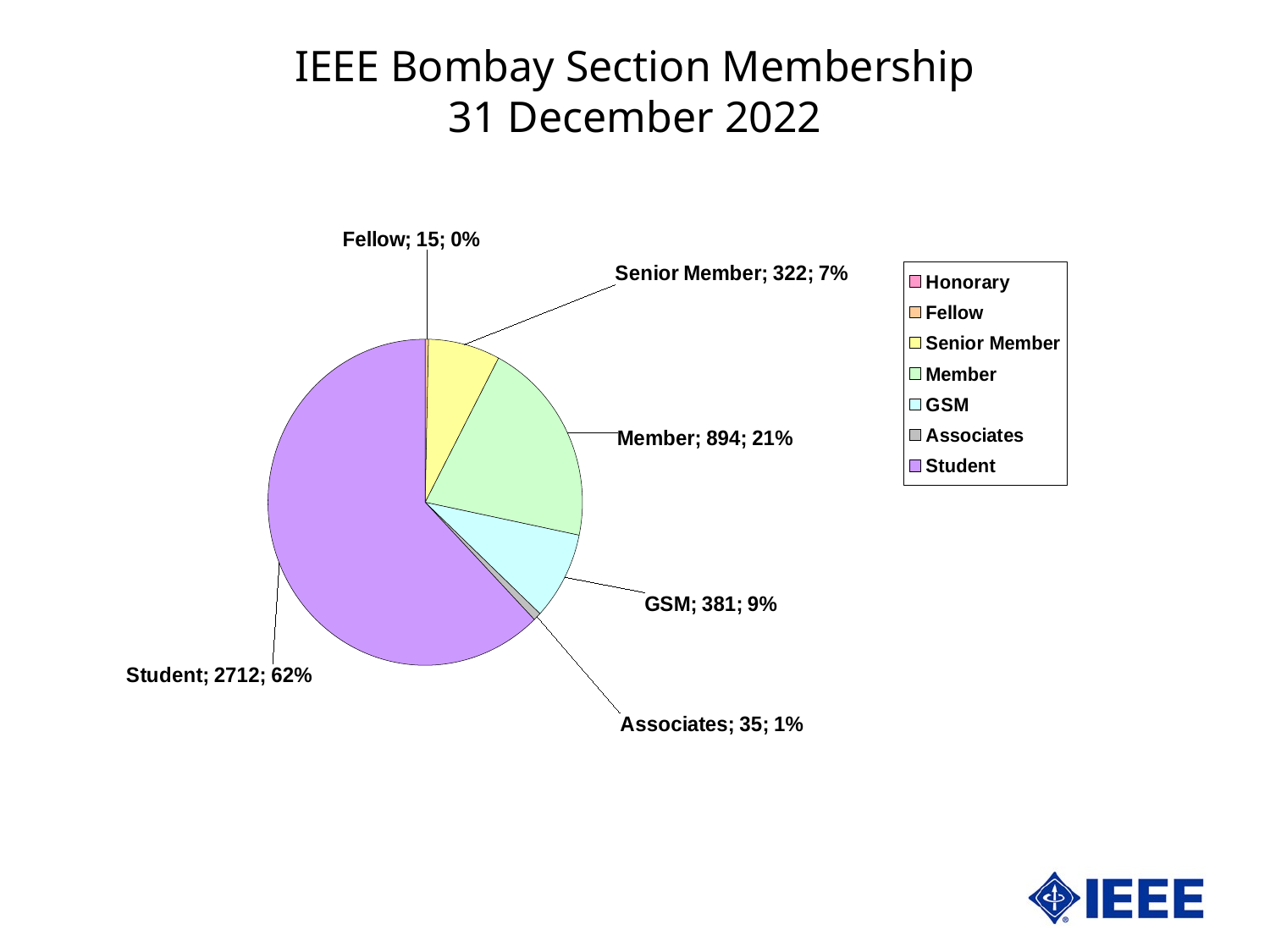
How many members are in the Student category? 2712 What is the title of the chart on the slide? IEEE Bombay Section Membership 31 December 2022 How many entries does the legend list? 7 Which category has the largest slice of the pie? Student Which of the labeled slices has the smallest value? Fellow What is the value shown for Member? 894 What type of chart is shown on the slide? pie chart What is the value shown for Senior Member? 322 What percentage share of the pie does the Member slice represent? 21% What is the value shown for GSM? 381 What percentage share of the pie does the Student slice represent? 62% What is the difference between the Member value and the GSM value? 513